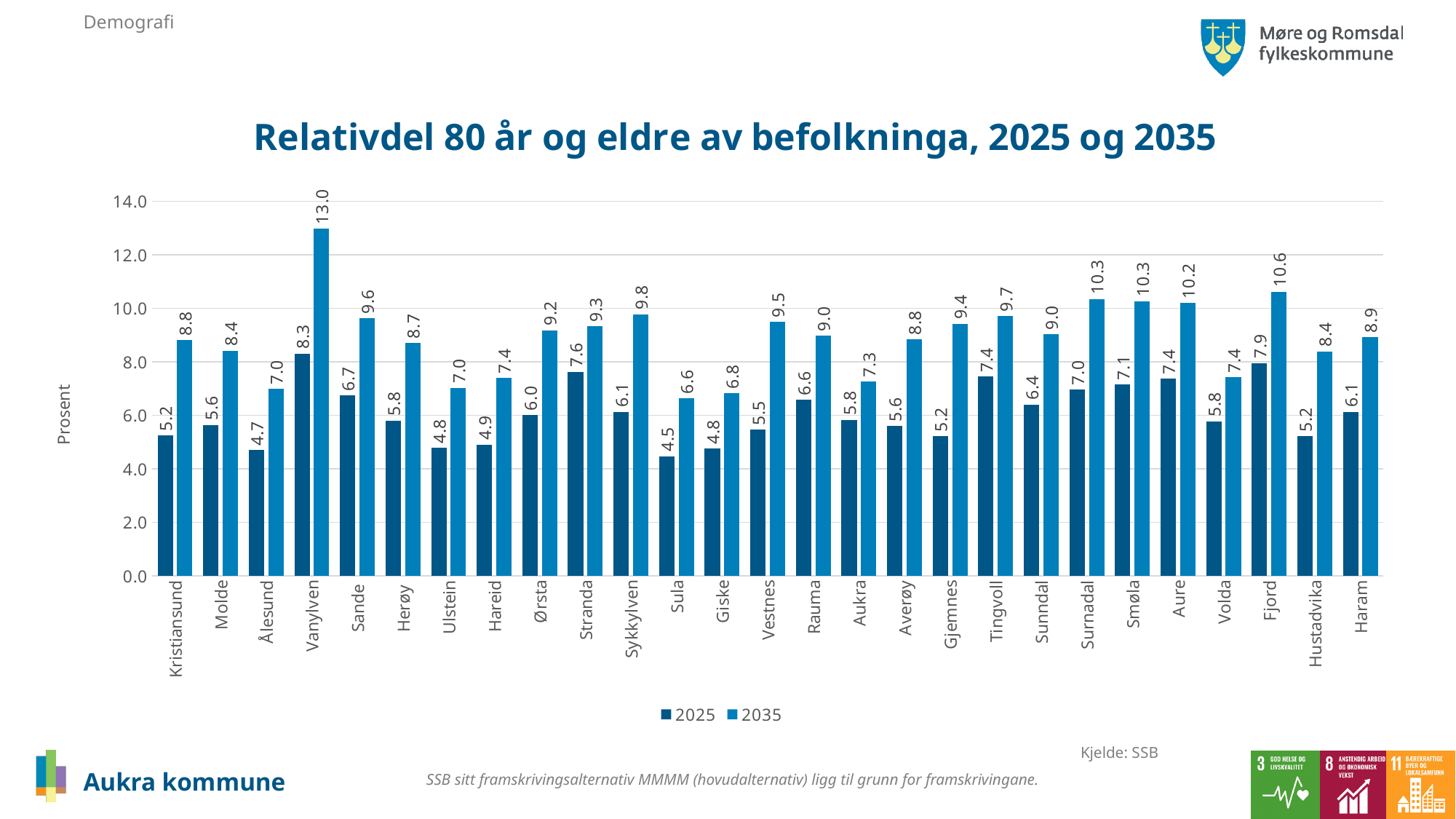
What is the title of the chart? Relativdel 80 år og eldre av befolkninga, 2025 og 2035 Which is larger: the 2025 value for Stranda or the 2025 value for Tingvoll? Stranda How many municipalities are shown on the x axis? 27 What kind of chart is shown on the slide? Bar chart What is the difference between the 2035 and 2025 values for Vestnes? 4.0 How many series does the legend list? 2 What is the value for Fjord in the 2035 series? 10.6 Which municipality has the highest value in the 2035 series? Vanylven What is the value for Vanylven in the 2025 series? 8.3 Which municipality has the lowest value in the 2025 series? Sula What is the value for Aukra in the 2035 series? 7.3 What is the label on the y axis? Prosent